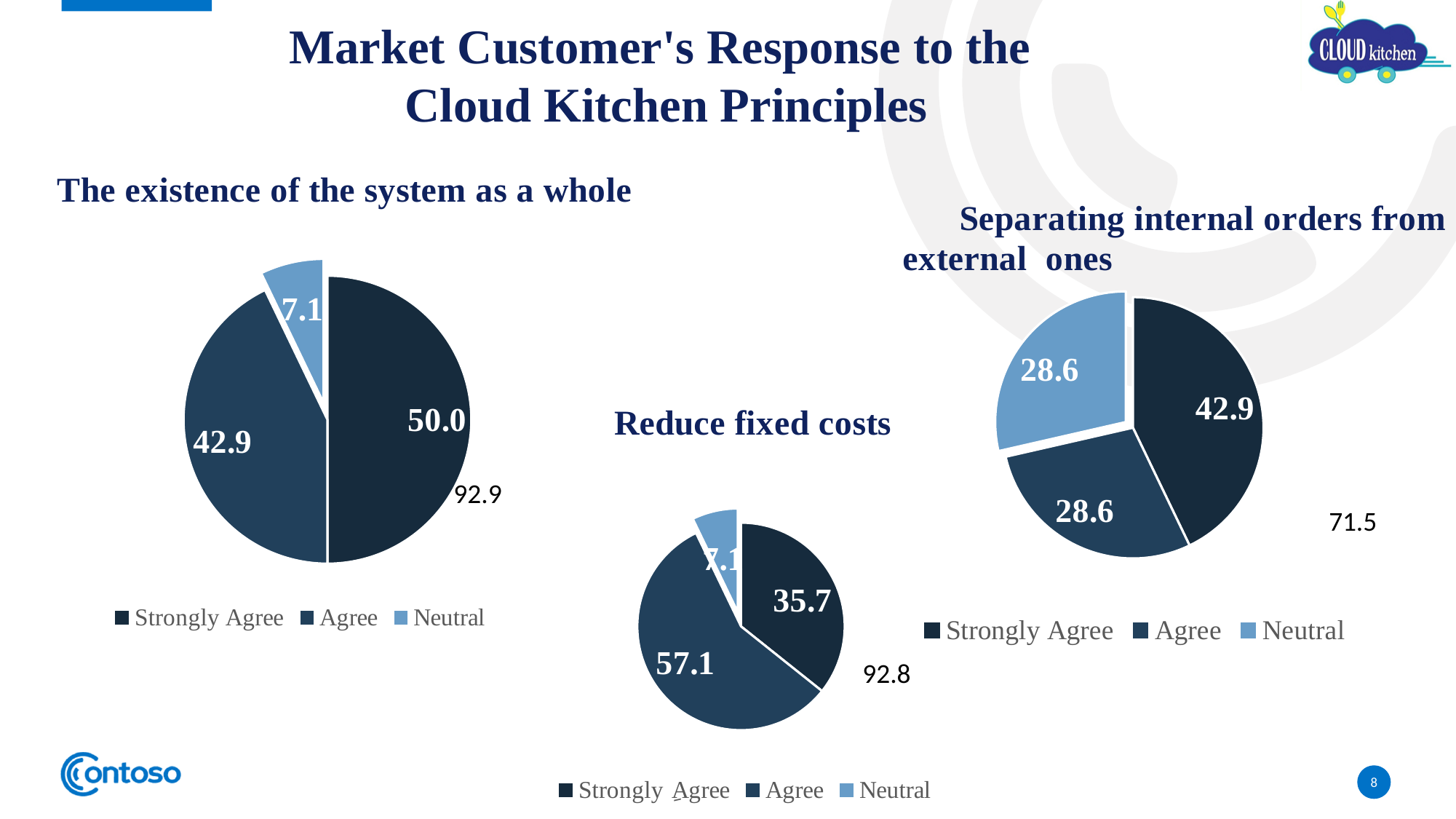
In the 'The existence of the system as a whole' chart, what is the difference between Strongly Agree and Agree? 7.1 How many slices does the 'Separating internal orders from external ones' chart have? 3 In the 'Separating internal orders from external ones' chart, what is the value for Strongly Agree? 42.9 In the 'Reduce fixed costs' chart, what is the value for Agree? 57.1 How many entries does the legend of the 'The existence of the system as a whole' chart list? 3 In the 'Separating internal orders from external ones' chart, which category has the highest value? Strongly Agree In the 'The existence of the system as a whole' chart, what is the value for Strongly Agree? 50.0 In the 'The existence of the system as a whole' chart, what is the value for Neutral? 7.1 In the 'Reduce fixed costs' chart, which is larger, Agree or Strongly Agree? Agree In the 'Reduce fixed costs' chart, what is the value for Strongly Agree? 35.7 What kind of chart is 'Reduce fixed costs'? Pie chart In the 'Reduce fixed costs' chart, which category has the lowest value? Neutral